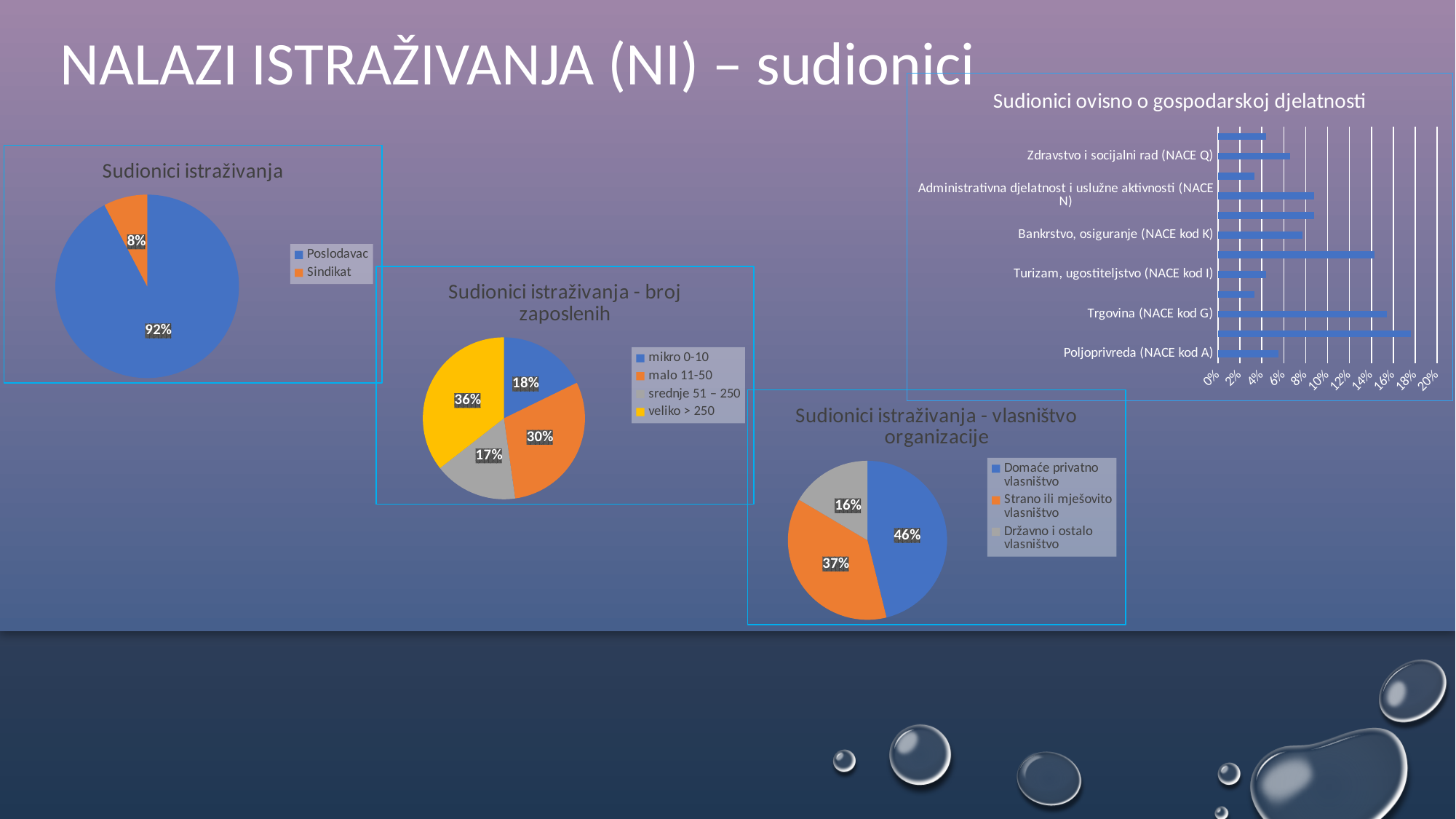
In the 'Sudionici istraživanja - broj zaposlenih' pie chart, which category has the smallest share? srednje 51 – 250 In the 'Sudionici istraživanja - vlasništvo organizacije' pie chart, what is the value for 'Strano ili mješovito vlasništvo'? 37% In the 'Sudionici istraživanja - broj zaposlenih' pie chart, which category has the largest share? veliko > 250 In the 'Sudionici istraživanja' pie chart, what share is Poslodavac? 92% How many categories does the 'Sudionici istraživanja - broj zaposlenih' pie chart have? 4 In the 'Sudionici ovisno o gospodarskoj djelatnosti' chart, is the value for 'Poljoprivreda (NACE kod A)' greater or less than 10%? less In the 'Sudionici istraživanja - vlasništvo organizacije' pie chart, which is larger: 'Domaće privatno vlasništvo' or 'Državno i ostalo vlasništvo'? Domaće privatno vlasništvo What type of chart is 'Sudionici ovisno o gospodarskoj djelatnosti'? bar chart In the 'Sudionici istraživanja - broj zaposlenih' pie chart, what is the value for 'malo 11-50'? 30% In the 'Sudionici istraživanja' pie chart, what share is Sindikat? 8% In the 'Sudionici ovisno o gospodarskoj djelatnosti' chart, is the value for 'Trgovina (NACE kod G)' greater or less than 10%? greater In the 'Sudionici istraživanja - broj zaposlenih' pie chart, what is the difference between 'veliko > 250' and 'mikro 0-10'? 18%